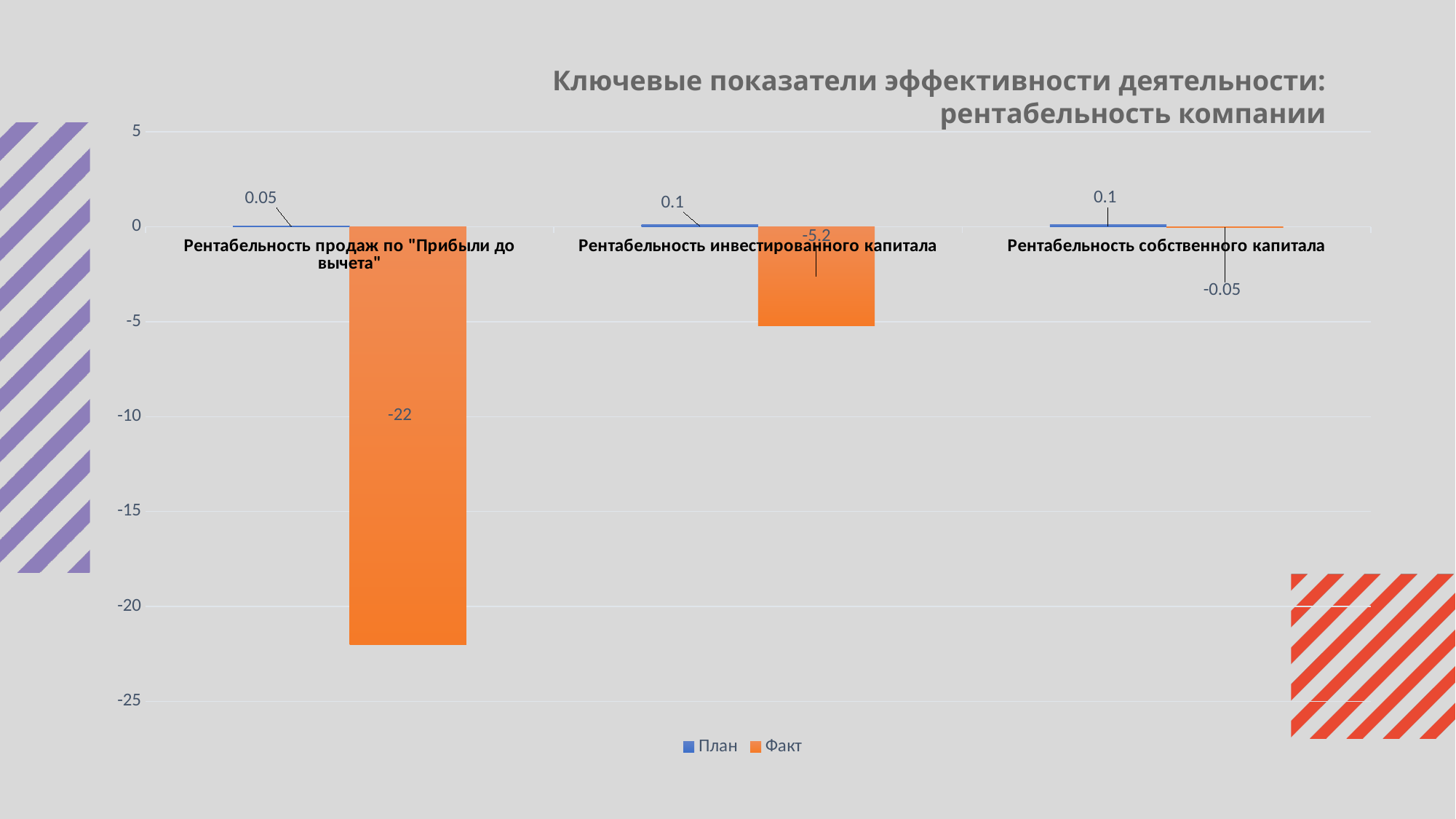
Which category has the lowest Факт value? Рентабельность продаж по "Прибыли до вычета" What is the План value for Рентабельность инвестированного капитала? 0.1 What type of chart is shown on the slide? Bar chart How many series does the legend list? 2 What is the План value for Рентабельность продаж по "Прибыли до вычета"? 0.05 What is the Факт value for Рентабельность продаж по "Прибыли до вычета"? -22 How many categories are shown on the x axis? 3 What is the Факт value for Рентабельность инвестированного капитала? -5.2 Which is larger: the Факт value for Рентабельность инвестированного капитала or the Факт value for Рентабельность продаж по "Прибыли до вычета"? Рентабельность инвестированного капитала Which category has the highest Факт value? Рентабельность собственного капитала What is the difference between the План and Факт values for Рентабельность инвестированного капитала? 5.3 What is the Факт value for Рентабельность собственного капитала? -0.05